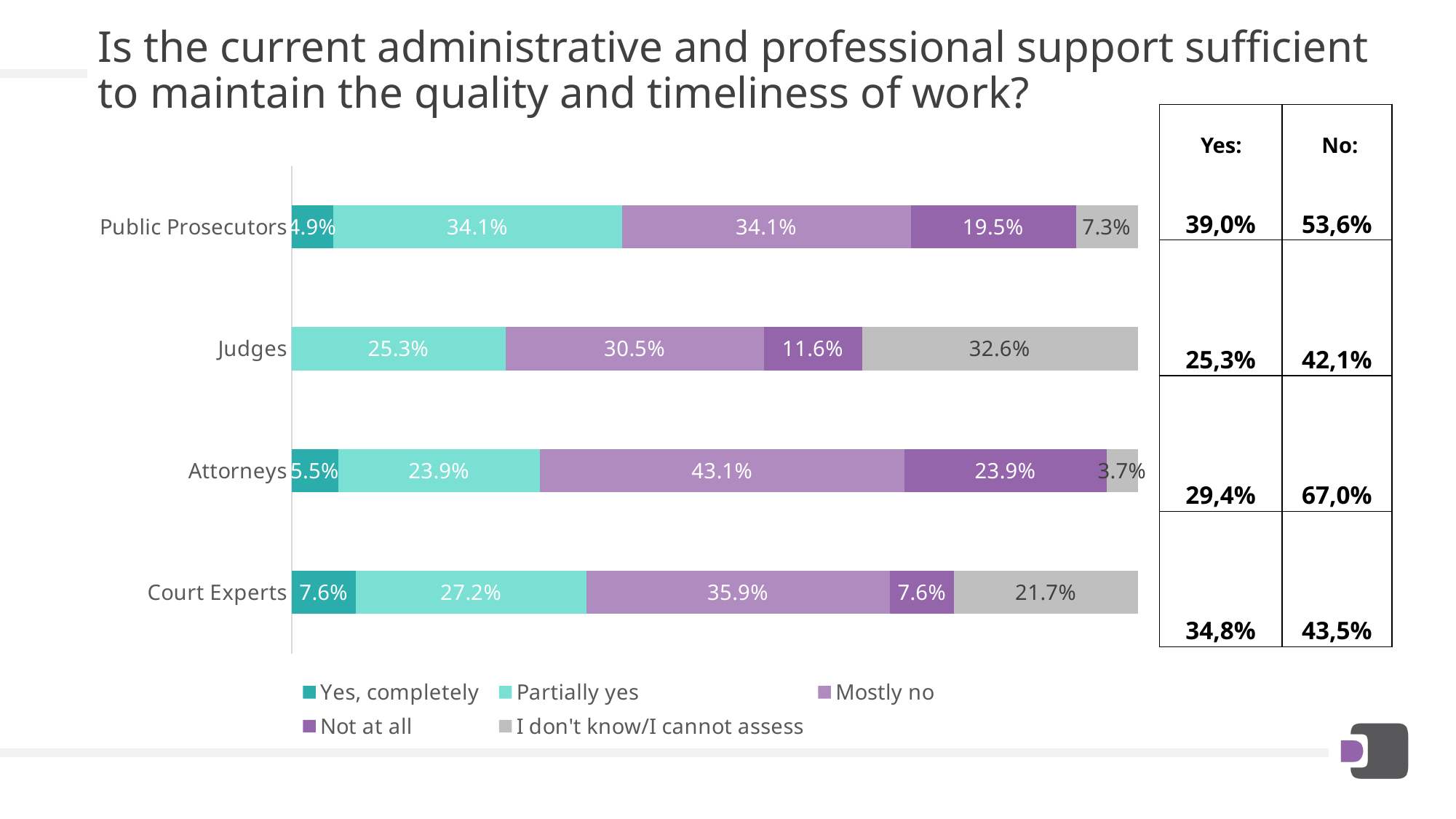
What percentage of Court Experts answered "Yes, completely"? 7.6% What percentage of Public Prosecutors answered "I don't know/I cannot assess"? 7.3% How many series does the legend list? 5 How many groups (categories) are shown on the chart? 4 Which group has the highest combined "No" share according to the table on the right? Attorneys What percentage of Attorneys answered "Not at all"? 23.9% What kind of chart is shown on the slide? Stacked bar chart Which group has the highest share of "Mostly no" responses? Attorneys What is the difference between the "Partially yes" share for Public Prosecutors and for Judges? 8.8% Which group has the lowest share of "I don't know/I cannot assess" responses? Attorneys What percentage of Judges answered "Mostly no"? 30.5% Which is larger: the "Not at all" share for Public Prosecutors or for Court Experts? Public Prosecutors